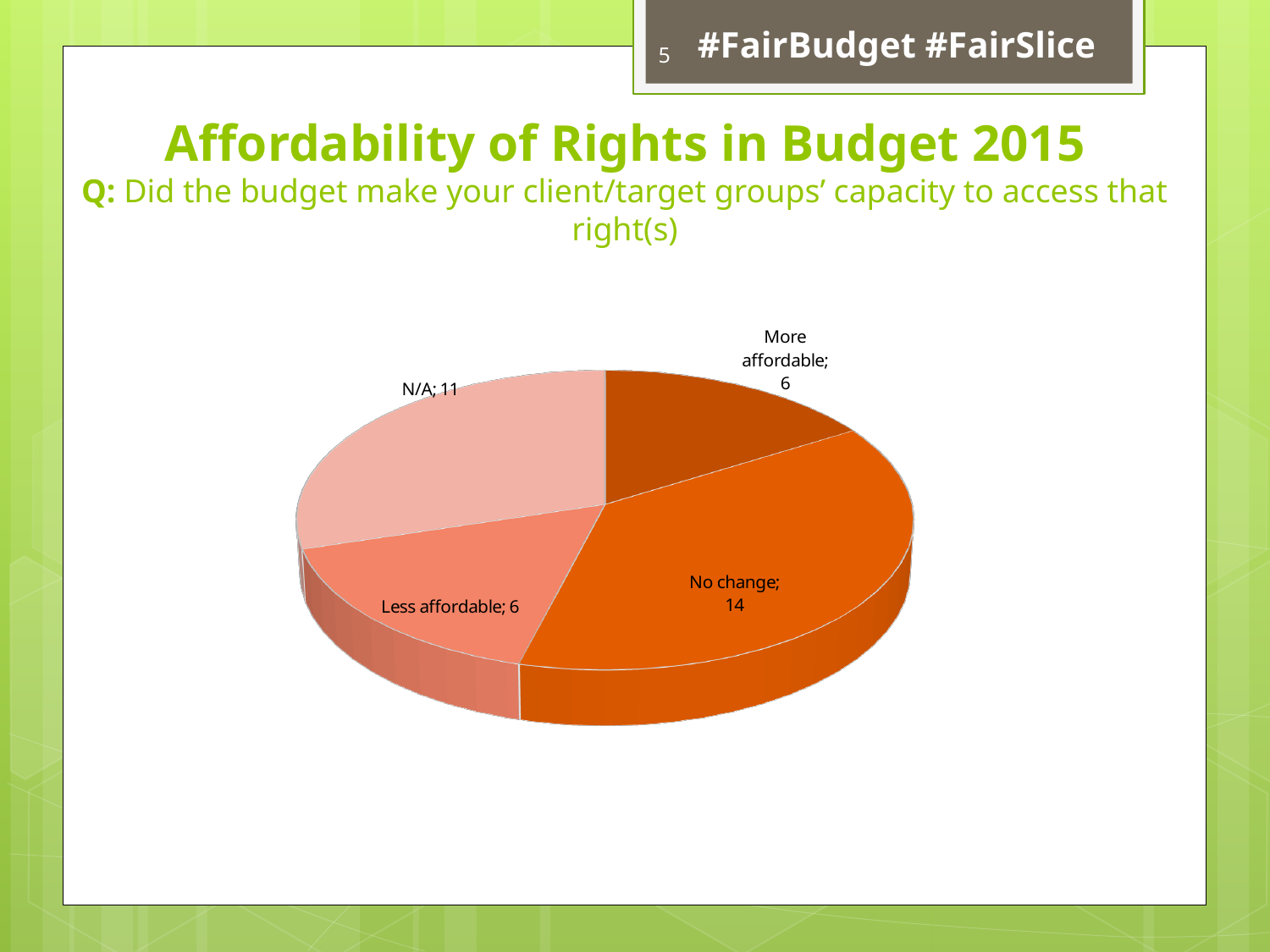
What is the difference between the values for "N/A" and "Less affordable"? 5 How many slices does the pie chart have? 4 What is the value for "Less affordable"? 6 What is the value for "N/A"? 11 Which two categories are tied for the smallest slice? More affordable and Less affordable What is the difference between the values for "No change" and "N/A"? 3 Which is larger, the value for "No change" or the value for "N/A"? No change What kind of chart is shown on the slide? Pie chart What is the title of the chart on the slide? Affordability of Rights in Budget 2015 Which category has the largest slice of the pie? No change What is the value for "More affordable"? 6 What is the value for "No change"? 14